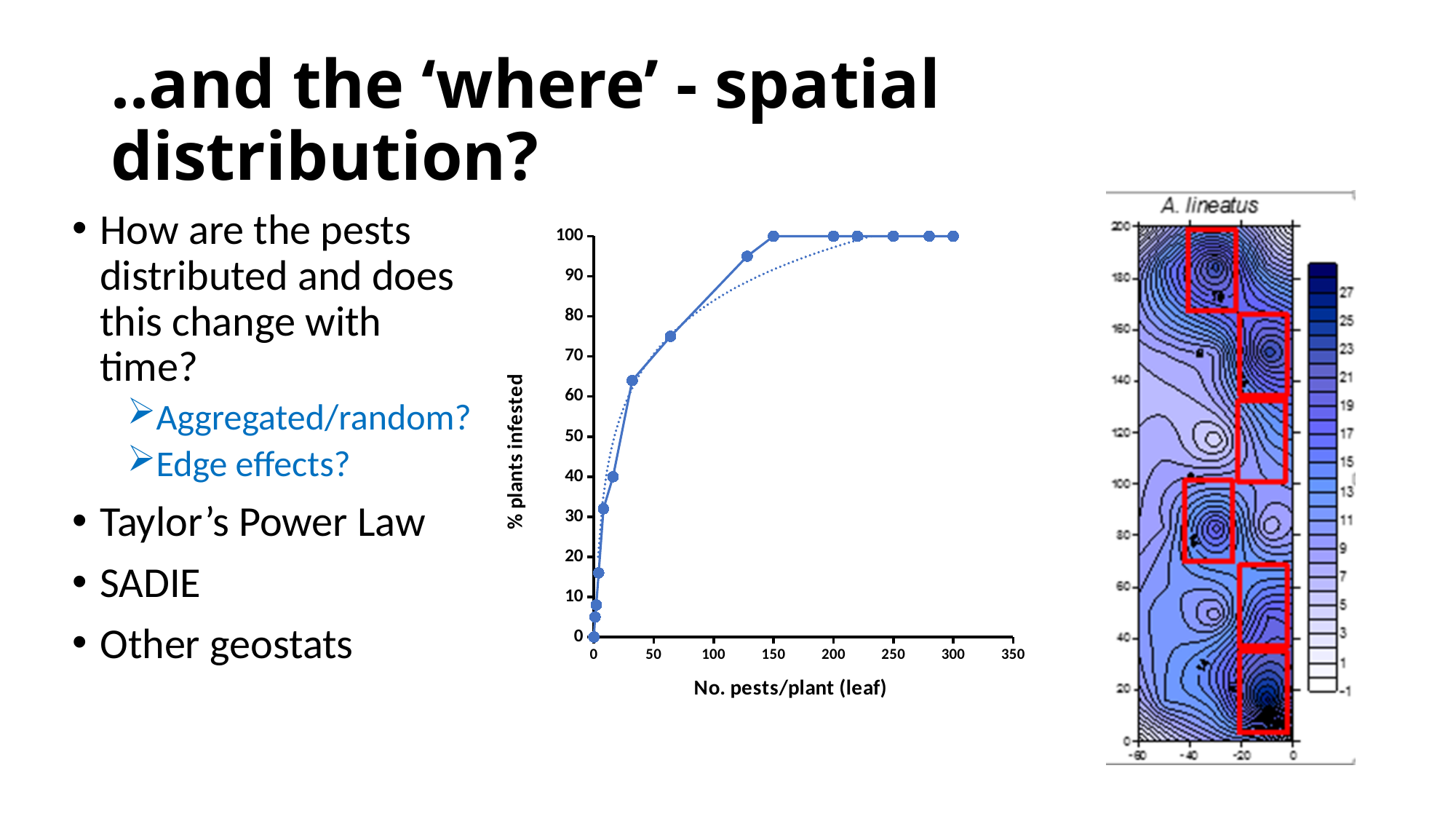
In the line chart, which is larger: the % plants infested at 250 pests/plant or at 0 pests/plant? 250 pests/plant What is the x-axis title of the line chart? No. pests/plant (leaf) What is the title shown above the contour map on the right of the slide? A. lineatus In the line chart, does % plants infested rise or fall as No. pests/plant (leaf) increases from 0 to 150? rise In the line chart, what is the % plants infested at 0 pests/plant (leaf)? 0 In the line chart, what is the % plants infested at 300 pests/plant (leaf)? 100 In the line chart, what is the highest % plants infested value reached? 100 In the line chart, is the % plants infested at 200 pests/plant (leaf) greater or less than 90? greater In the line chart, what is the % plants infested at 150 pests/plant (leaf)? 100 What kind of chart is the chart of % plants infested against No. pests/plant (leaf)? line chart In the line chart, is the highest plotted % plants infested for fewer than 50 pests/plant (leaf) greater or less than 70? less